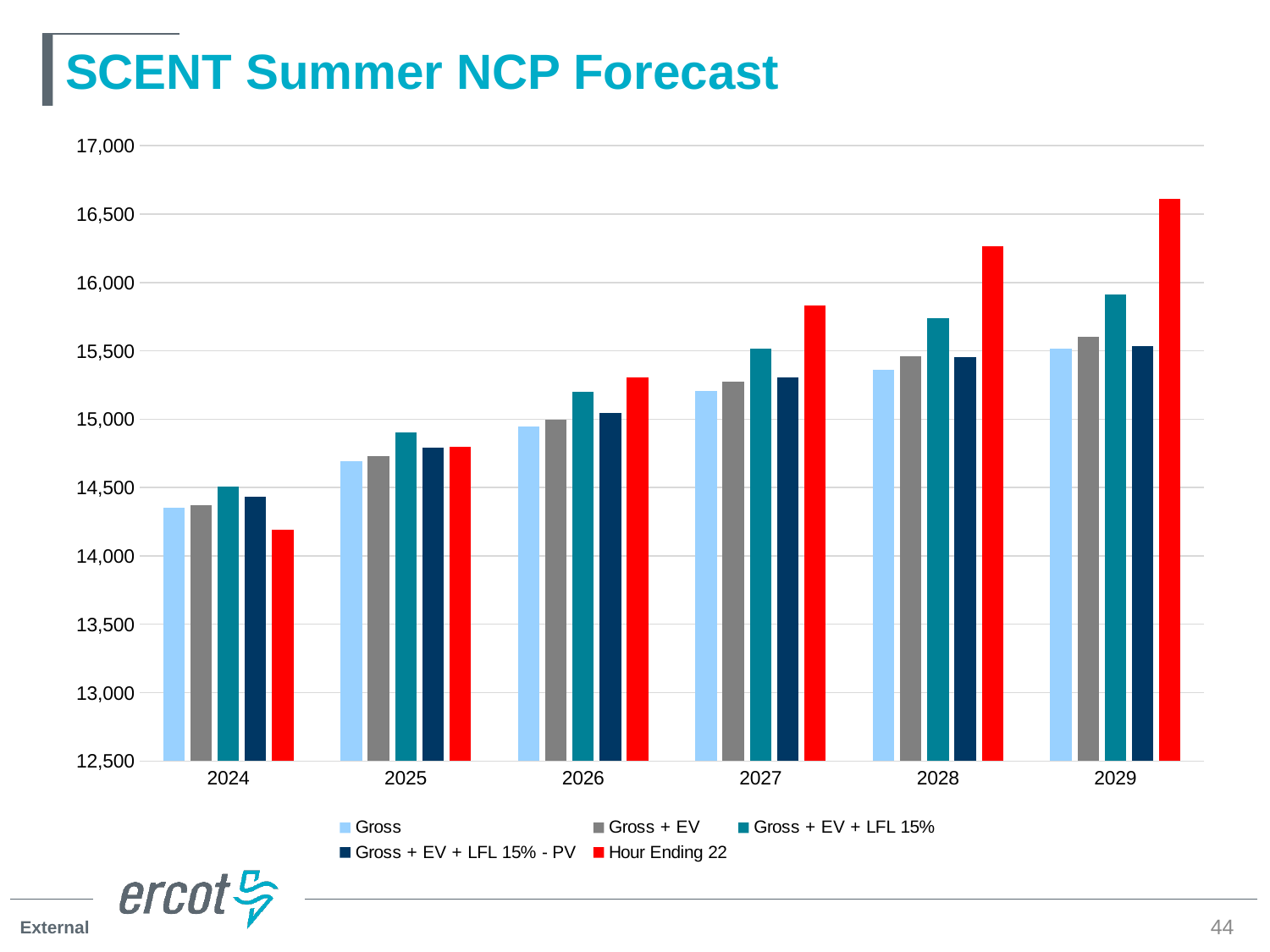
How many years are shown on the x axis? 6 Is the Gross value for 2027 greater or less than 15,000? greater Is the Hour Ending 22 value for 2029 greater or less than 16,500? greater In 2028, which is larger: Hour Ending 22 or Gross? Hour Ending 22 Is the Hour Ending 22 value for 2024 greater or less than 14,500? less In 2024, which is larger: Gross + EV + LFL 15% or Hour Ending 22? Gross + EV + LFL 15% What kind of chart is shown on the slide? bar chart Which year has the highest Hour Ending 22 value? 2029 How many series does the legend list? 5 What colour are the Hour Ending 22 bars? red Which year has the lowest Gross value? 2024 Do the Hour Ending 22 values rise or fall from 2024 to 2029? rise